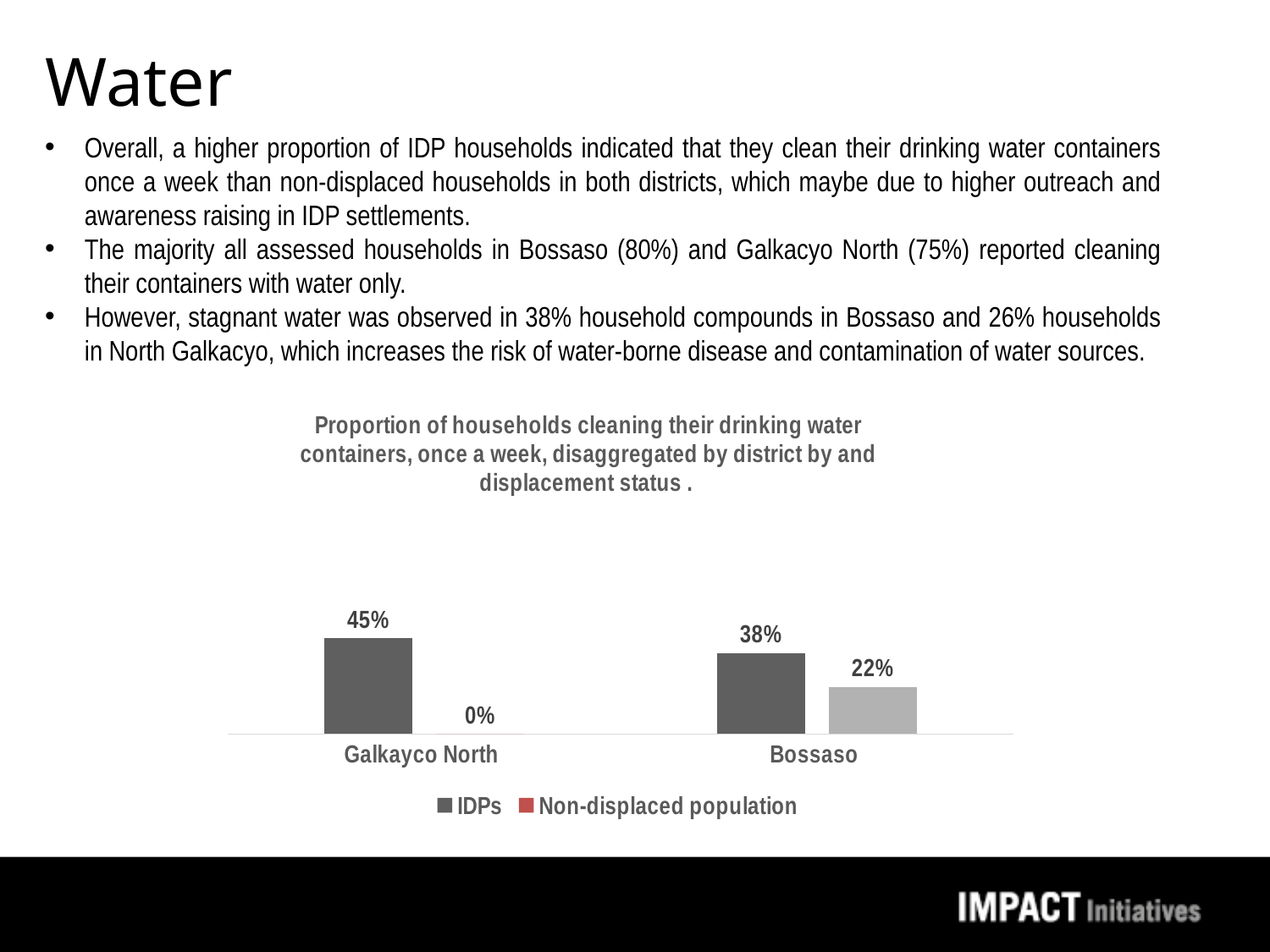
What is the value for IDPs in Galkayco North? 45% How many districts are shown on the x axis? 2 What is the difference between the IDPs value and the Non-displaced population value in Bossaso? 16% Which district has the lowest value for the Non-displaced population? Galkayco North In Bossaso, which is larger: the value for IDPs or for the Non-displaced population? IDPs What is the difference between the IDPs values for Galkayco North and Bossaso? 7% What is the value for IDPs in Bossaso? 38% Which district has the highest value for IDPs? Galkayco North How many series does the legend list? 2 What is the value for the Non-displaced population in Bossaso? 22% What is the value for the Non-displaced population in Galkayco North? 0% What kind of chart is shown on the slide? Bar chart